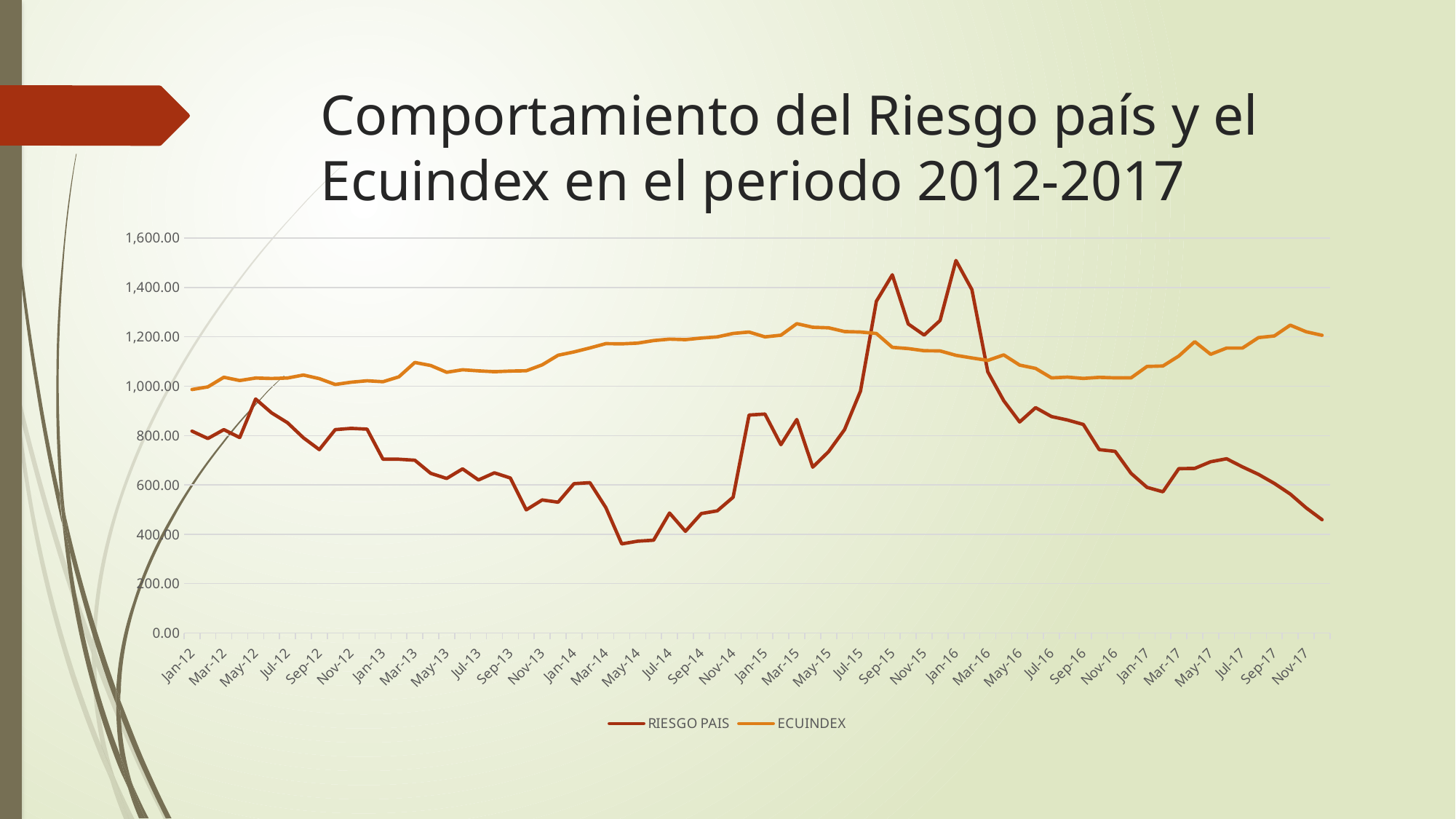
What are the two series named in the legend? RIESGO PAIS and ECUINDEX What is the title of the chart on the slide? Comportamiento del Riesgo país y el Ecuindex en el periodo 2012-2017 How many series does the legend list? 2 Is the value of RIESGO PAIS at Nov-17 greater or less than 600.00? less What kind of chart is shown on the slide? Line chart Is the value of RIESGO PAIS at May-14 greater or less than 400.00? less Is the value of ECUINDEX at Mar-15 greater or less than 1,200.00? greater At Jan-14, which series has the higher value, RIESGO PAIS or ECUINDEX? ECUINDEX Which series reaches the highest value anywhere on the chart? RIESGO PAIS At Jan-16, which series has the higher value, RIESGO PAIS or ECUINDEX? RIESGO PAIS Does the RIESGO PAIS series rise or fall overall from Mar-16 to Nov-17? Fall